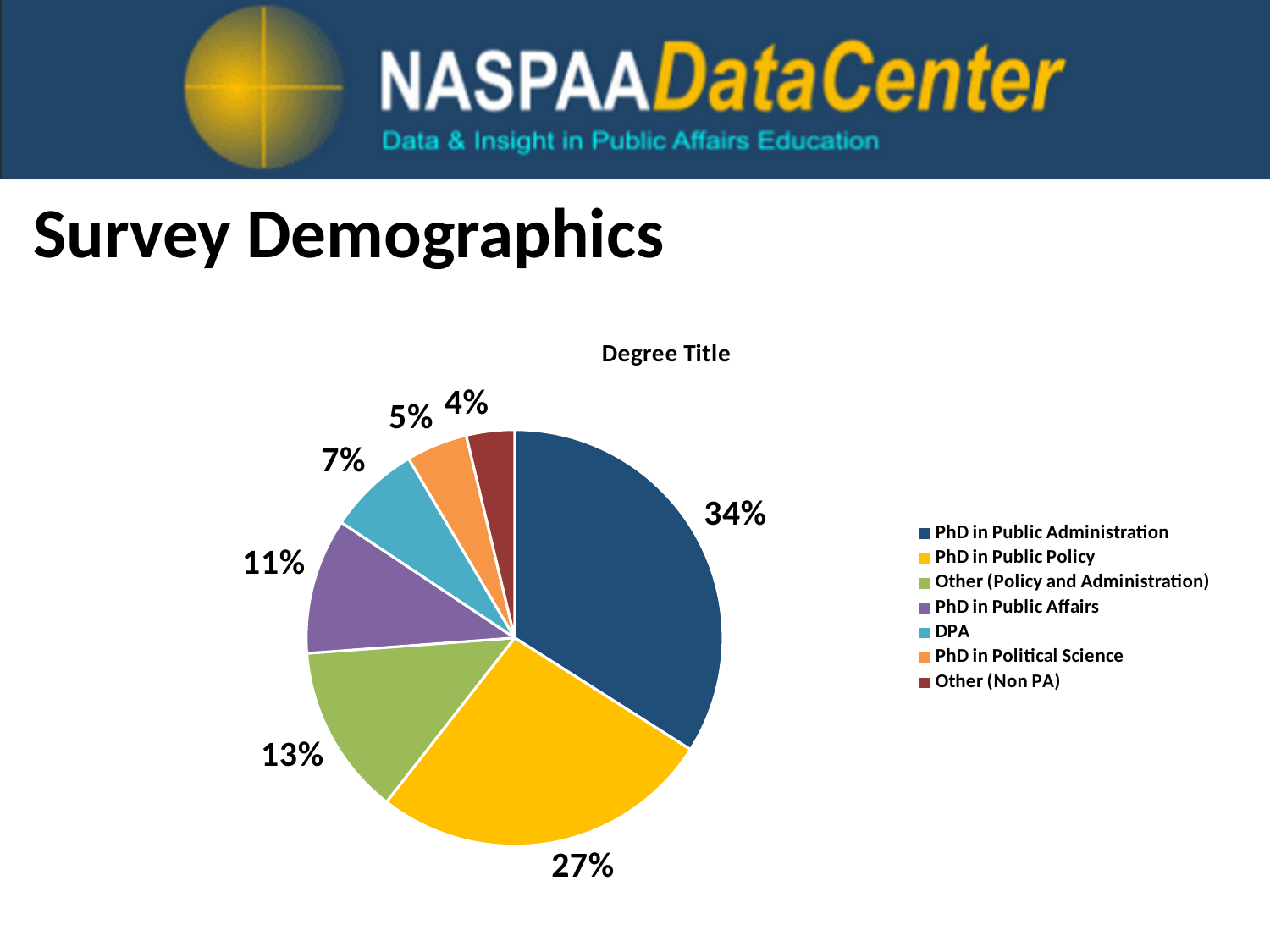
Which category has the smallest slice? Other (Non PA) Which is larger, DPA or PhD in Political Science? DPA What is the value for PhD in Public Affairs? 11% Which category has the largest slice? PhD in Public Administration What is the title of the chart? Degree Title What is the value for Other (Non PA)? 4% What is the value for DPA? 7% What is the difference between PhD in Public Administration and PhD in Public Policy? 7% How many categories does the pie chart show? 7 What share of the pie does PhD in Public Administration hold? 34% What is the value for PhD in Public Policy? 27% What is the value for Other (Policy and Administration)? 13%